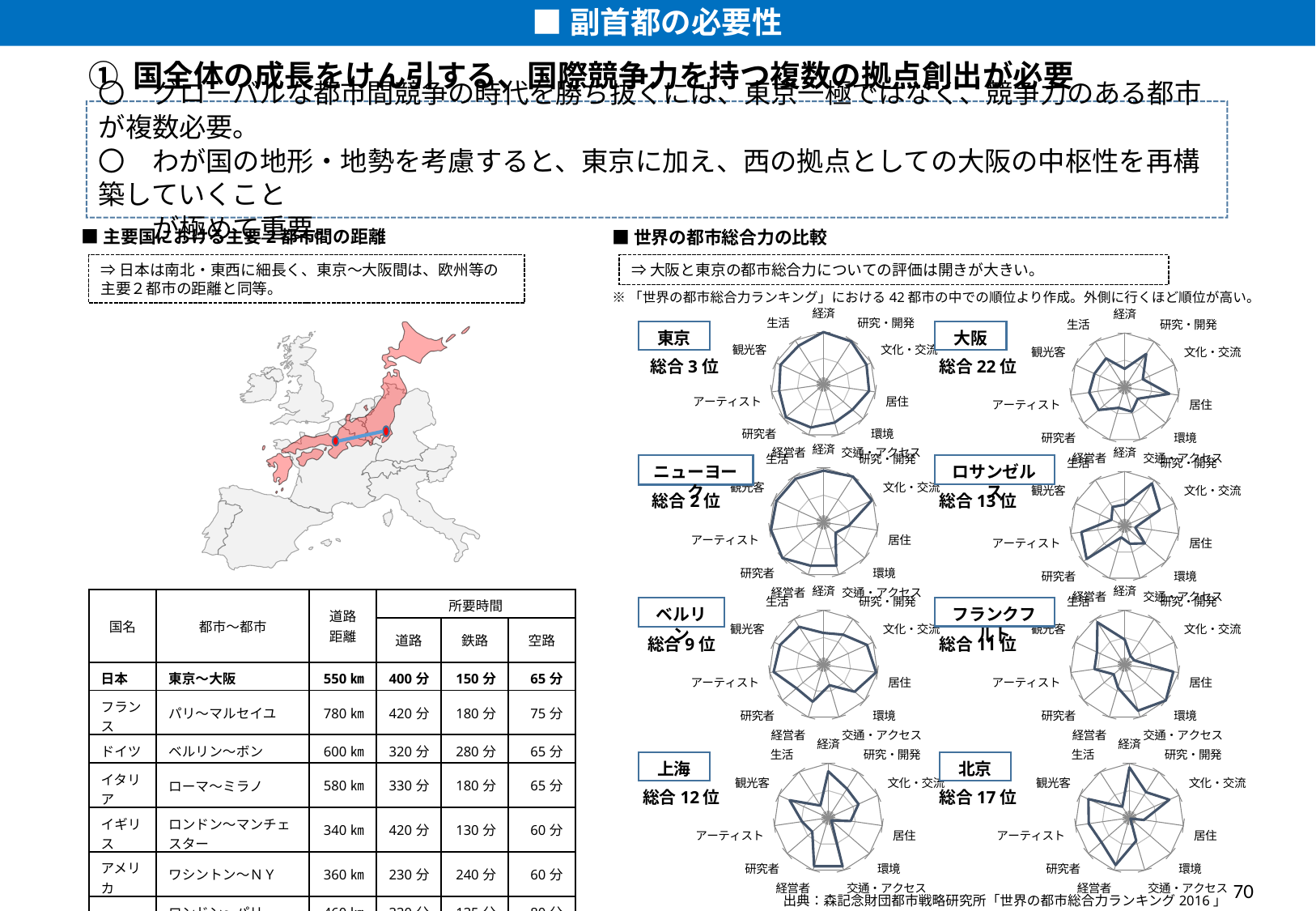
In the 「世界の都市総合力の比較」 section, which city has the best (lowest-numbered) overall rank among the eight radar charts? ニューヨーク According to the note above the radar charts, does a point further from the centre indicate a higher or lower rank? Higher rank In the 「世界の都市総合力の比較」 section, which city is ranked higher overall, ベルリン or 上海? ベルリン In the 「世界の都市総合力の比較」 section, what overall rank (総合) is printed next to the 北京 radar chart? 総合17位 In the 「世界の都市総合力の比較」 section, what overall rank (総合) is printed next to the 大阪 radar chart? 総合22位 In the 「世界の都市総合力の比較」 section, which radar chart covers a larger area, 東京 or 大阪? 東京 According to the note above the radar charts, how many cities are included in the 「世界の都市総合力ランキング」 from which the charts were made? 42都市 In the 「世界の都市総合力の比較」 section, which city has the worst (highest-numbered) overall rank among the eight radar charts? 大阪 In the 「世界の都市総合力の比較」 section, what overall rank (総合) is printed next to the 東京 radar chart? 総合3位 In the 「世界の都市総合力の比較」 section, what overall rank (総合) is printed next to the ニューヨーク radar chart? 総合2位 How many radar charts are shown in the 「世界の都市総合力の比較」 section? 8 What kind of charts are used in the 「世界の都市総合力の比較」 section on the right of the slide? Radar charts